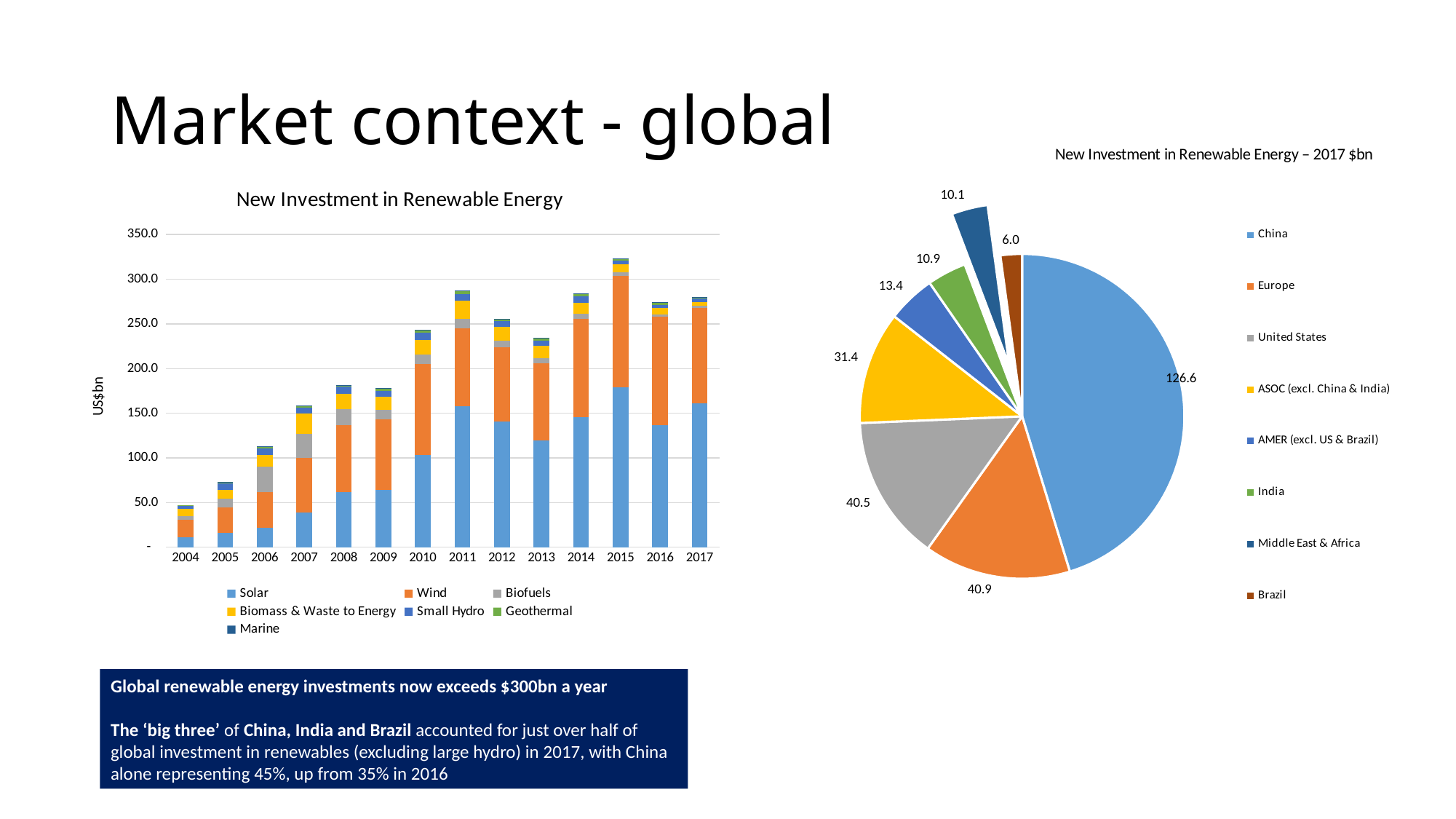
How many years are shown on the x axis of the left bar chart? 14 In the pie chart 'New Investment in Renewable Energy – 2017 $bn', which region has the smallest slice? Brazil In the left bar chart, do total investments rise or fall from 2004 to 2011? rise In the pie chart 'New Investment in Renewable Energy – 2017 $bn', what is the value for Brazil? 6.0 In the left bar chart, is the total for 2015 greater or less than 300.0? greater In the pie chart 'New Investment in Renewable Energy – 2017 $bn', what is the value for China? 126.6 How many series does the legend of the left bar chart list? 7 In the left bar chart, which year has the highest total investment? 2015 In the left bar chart, which year has the lowest total investment? 2004 What type of chart is the left chart titled 'New Investment in Renewable Energy'? Stacked bar chart In the pie chart 'New Investment in Renewable Energy – 2017 $bn', what is the difference between the values for China and Europe? 85.7